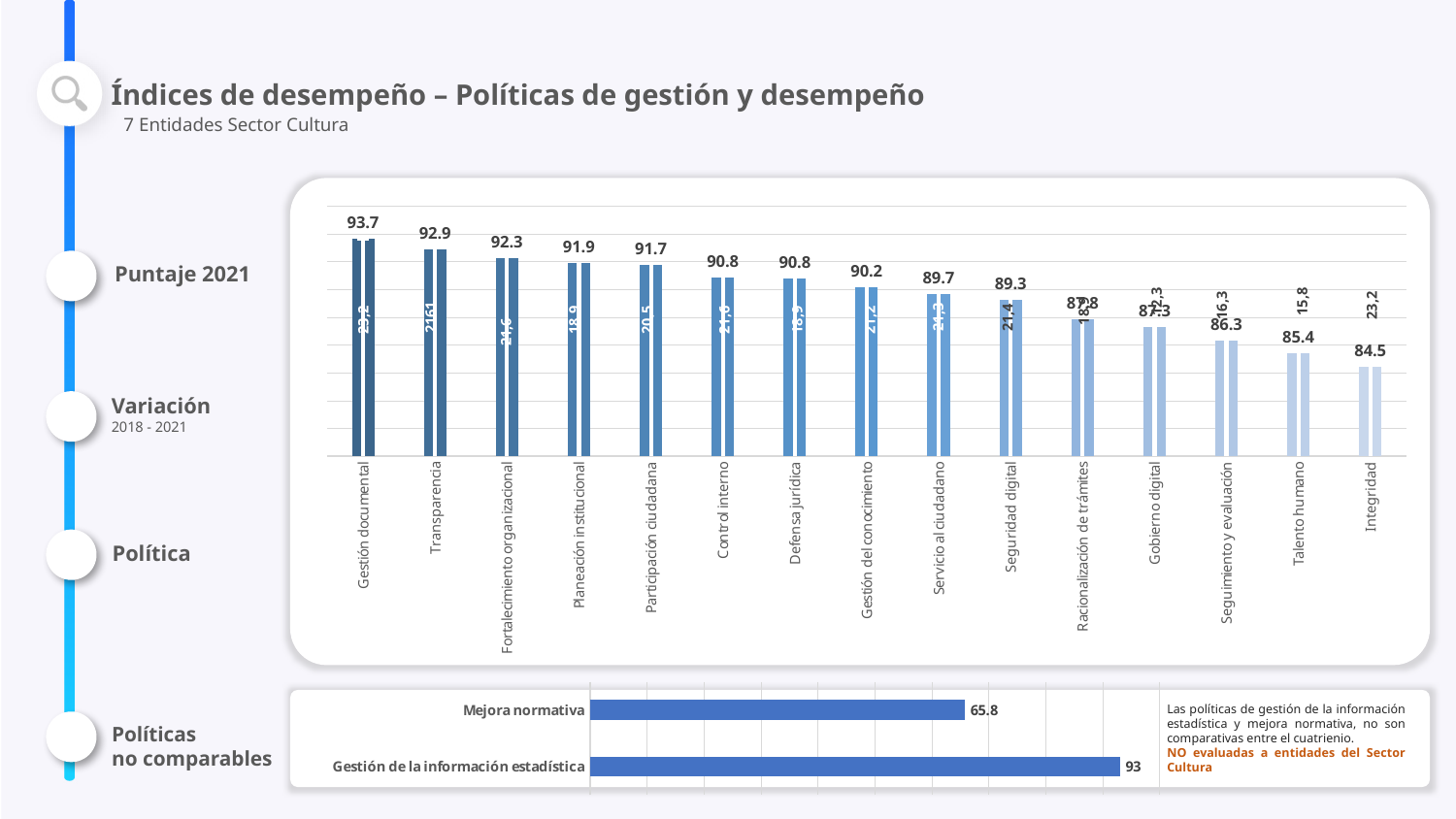
How many policies are shown in the top chart? 15 In the top chart, what is the difference between the 2021 scores of Gestión documental and Integridad? 9.2 In the top chart, what is the 2021 score for Seguridad digital? 89.3 In the top chart, which policy has the highest 2021 score? Gestión documental In the top chart, what is the 2021 score for Gestión documental? 93.7 In the top chart, which has a higher 2021 score, Control interno or Talento humano? Control interno In the top chart, what is the 2021 score for Transparencia? 92.9 In the bottom chart, what is the value for Mejora normativa? 65.8 In the top chart, which policy has the lowest 2021 score? Integridad In the bottom chart, what is the value for Gestión de la información estadística? 93 What kind of chart is the bottom chart? bar chart Do the 2021 scores in the top chart rise or fall from left to right? fall